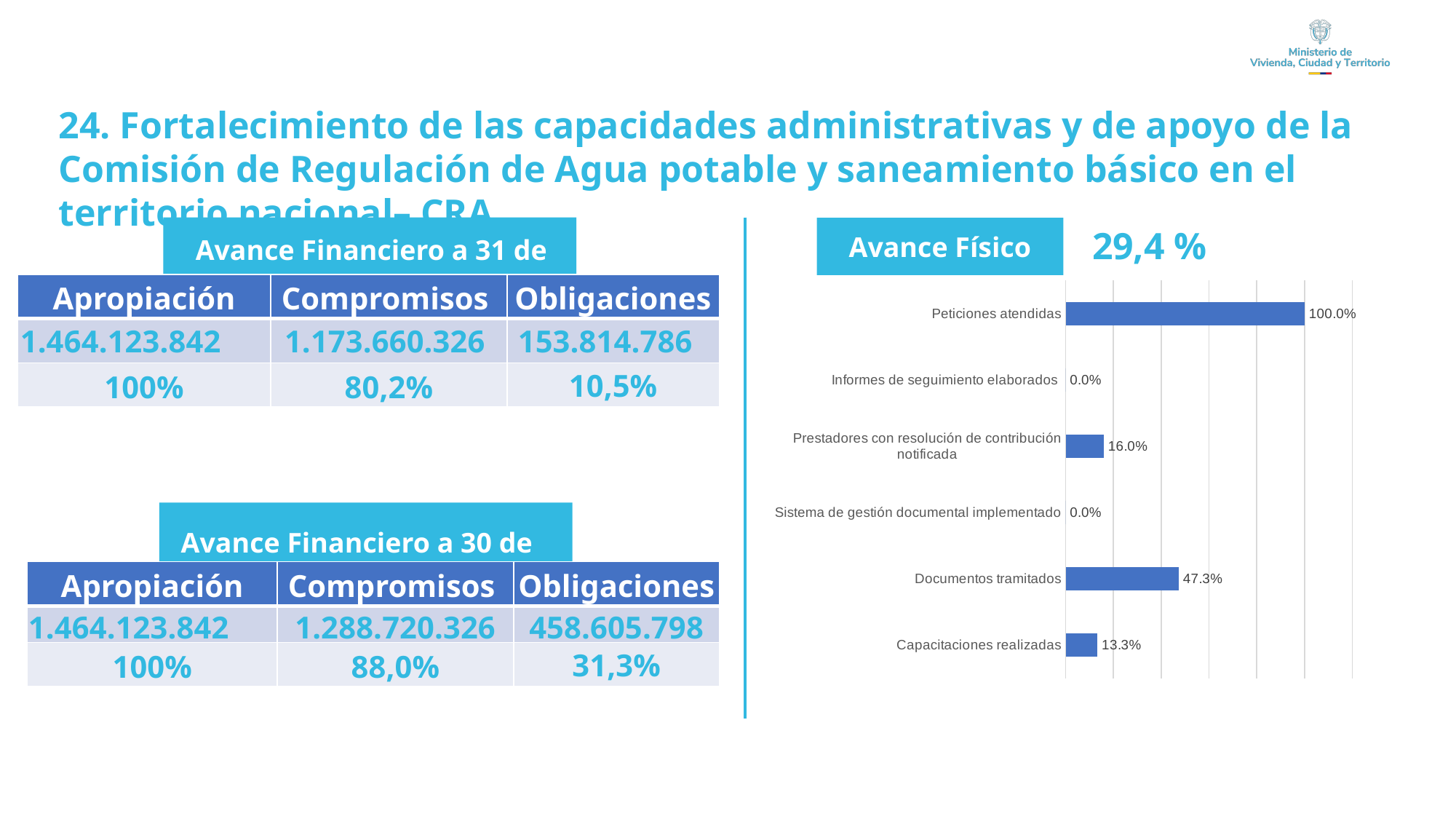
What overall Avance Físico percentage is shown above the bar chart? 29,4 % How many categories are shown in the bar chart? 6 What is the value for Peticiones atendidas in the bar chart? 100.0% What is the value for Documentos tramitados in the bar chart? 47.3% What is the value for Informes de seguimiento elaborados in the bar chart? 0.0% What is the value for Capacitaciones realizadas in the bar chart? 13.3% What is the difference between the values for Documentos tramitados and Capacitaciones realizadas in the bar chart? 34.0% Which category has the highest value in the bar chart? Peticiones atendidas How many categories in the bar chart have a value of 0.0%? 2 What is the value for Prestadores con resolución de contribución notificada in the bar chart? 16.0% Which is larger in the bar chart: Prestadores con resolución de contribución notificada or Capacitaciones realizadas? Prestadores con resolución de contribución notificada What kind of chart is shown on the right side of the slide? Bar chart